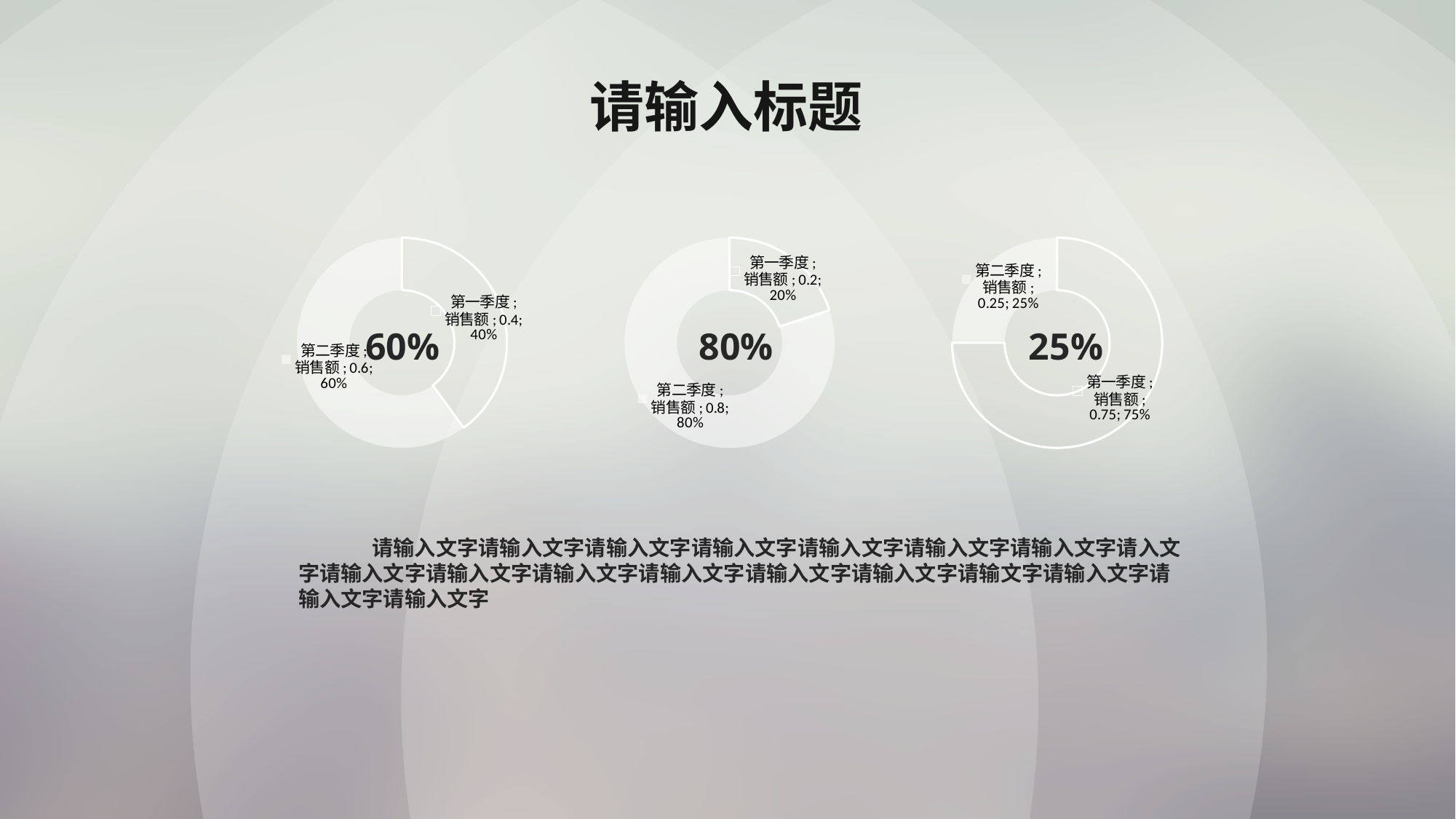
In the right chart, what percentage share is labelled for 第二季度? 25% In the middle chart, what is the value shown for 第一季度 销售额? 0.2 In the left chart, what percentage share is labelled for 第二季度? 60% In the right chart, what is the value shown for 第一季度 销售额? 0.75 What kind of chart is the middle chart? Doughnut (pie) chart In the right chart, which quarter has the largest share? 第一季度 How many slices does the left chart have? 2 In the left chart, what is the value shown for 第一季度 销售额? 0.4 In the middle chart, what percentage share is labelled for 第二季度? 80% In the left chart, which quarter has the larger share, 第一季度 or 第二季度? 第二季度 In the middle chart, which quarter has the smallest share? 第一季度 In the middle chart, what is the difference between the 第二季度 and 第一季度 values? 0.6